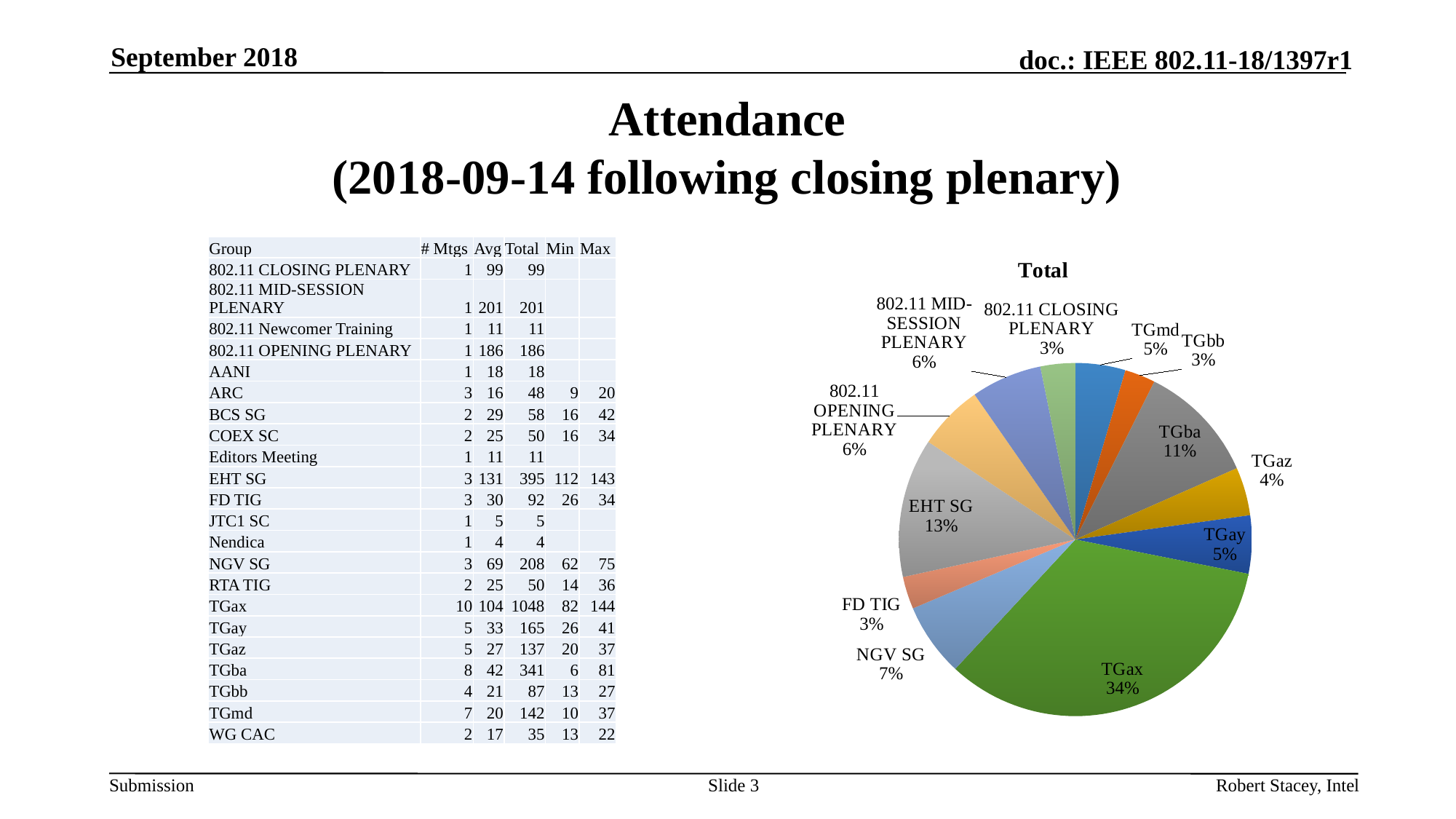
What share of the pie does NGV SG represent? 7% What share of the pie does TGmd represent? 5% What share of the pie does TGax represent? 34% What is the difference in percentage points between the TGax slice and the EHT SG slice? 21 What kind of chart is shown on the slide? pie chart Which group has the largest slice of the pie? TGax What is the difference in percentage points between the EHT SG slice and the TGba slice? 2 Which slice is larger, EHT SG or TGba? EHT SG What is the title of the pie chart? Total